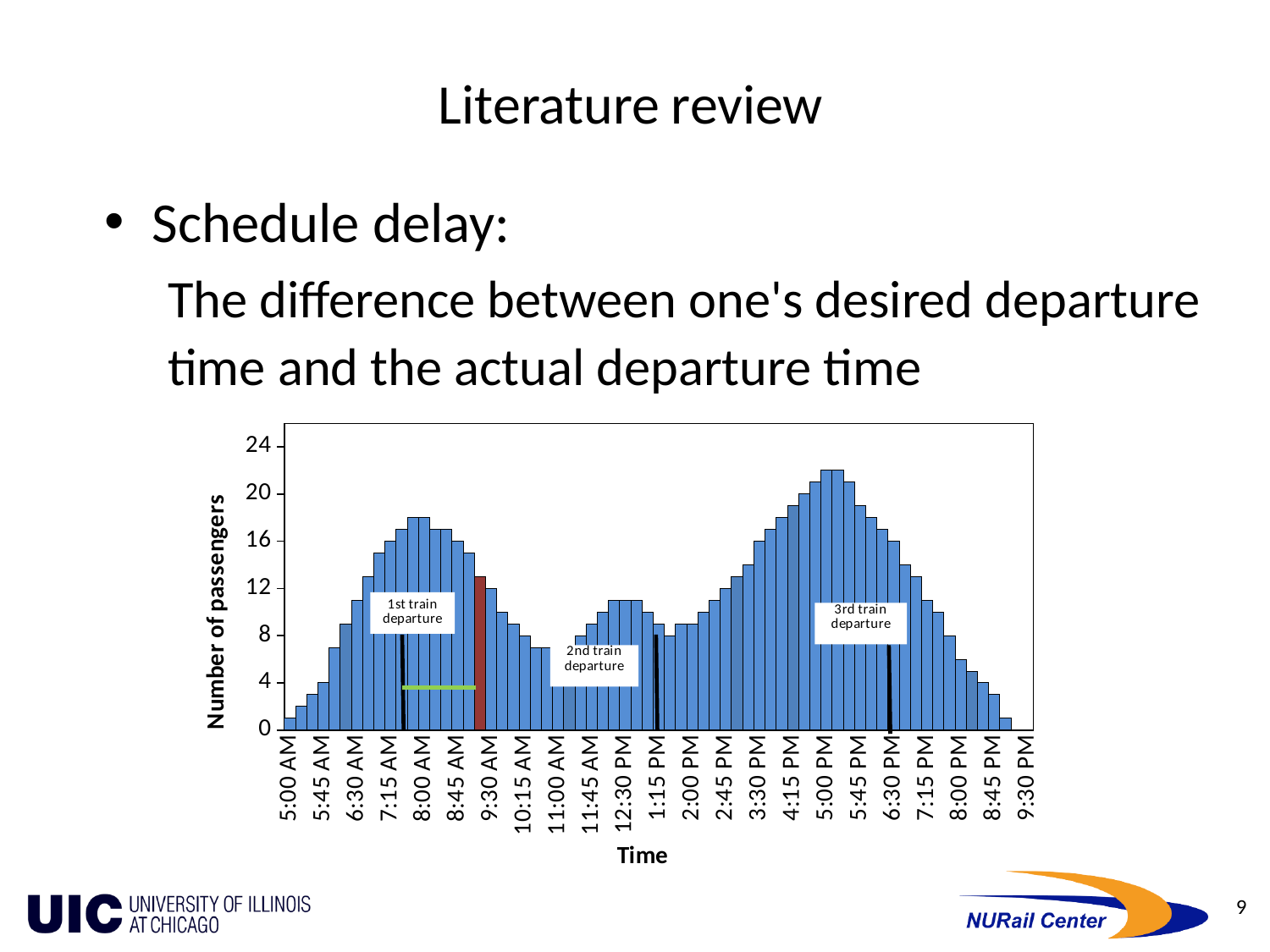
Is the number of passengers at 8:00 AM greater or less than 16? greater Is the number of passengers at 9:30 PM greater or less than 4? less How many train departures are marked on the chart? 3 What is the label of the vertical axis? Number of passengers Is the number of passengers at 12:30 PM greater or less than 8? greater Which has more passengers, 8:00 AM or 5:00 PM? 5:00 PM At which time does the number of passengers reach its highest value? 5:00 PM Do the number of passengers rise or fall from 5:00 PM to 9:30 PM? fall What kind of chart is shown on the slide? bar chart Which has more passengers, 8:00 AM or 12:30 PM? 8:00 AM